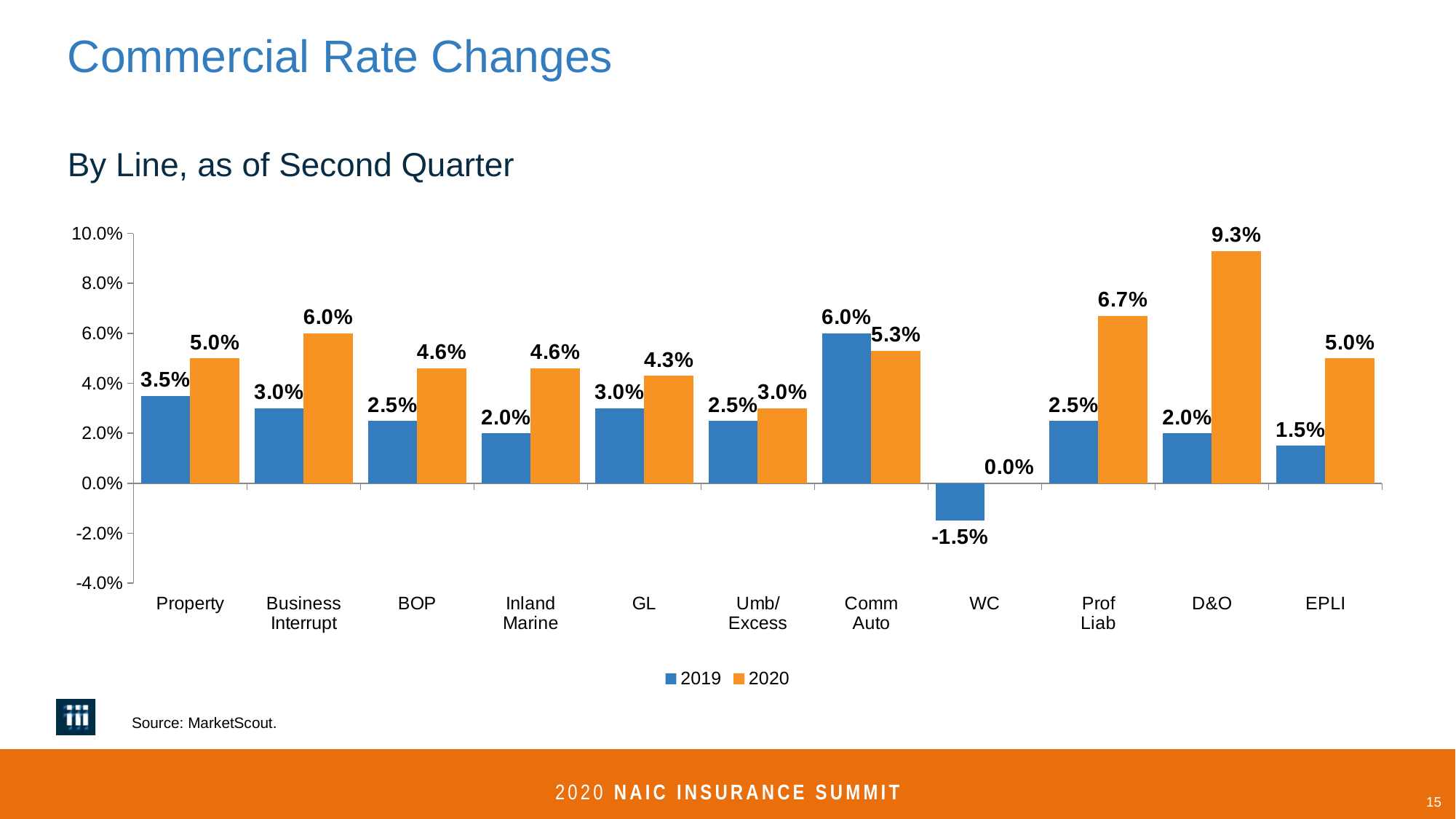
What is the 2019 rate change for WC? -1.5% What is the difference between the 2020 and 2019 rate changes for D&O? 7.3% What is the 2020 rate change for WC? 0.0% Which line has the highest 2020 rate change? D&O How many series does the legend list? 2 Which line has the lowest 2019 rate change? WC What kind of chart is shown on the slide? Bar chart How many lines of business are shown on the x axis? 11 What is the source cited for the chart? MarketScout What is the 2020 rate change for D&O? 9.3% What is the 2020 rate change for Prof Liab? 6.7% Which is larger for Comm Auto, the 2019 or the 2020 rate change? 2019